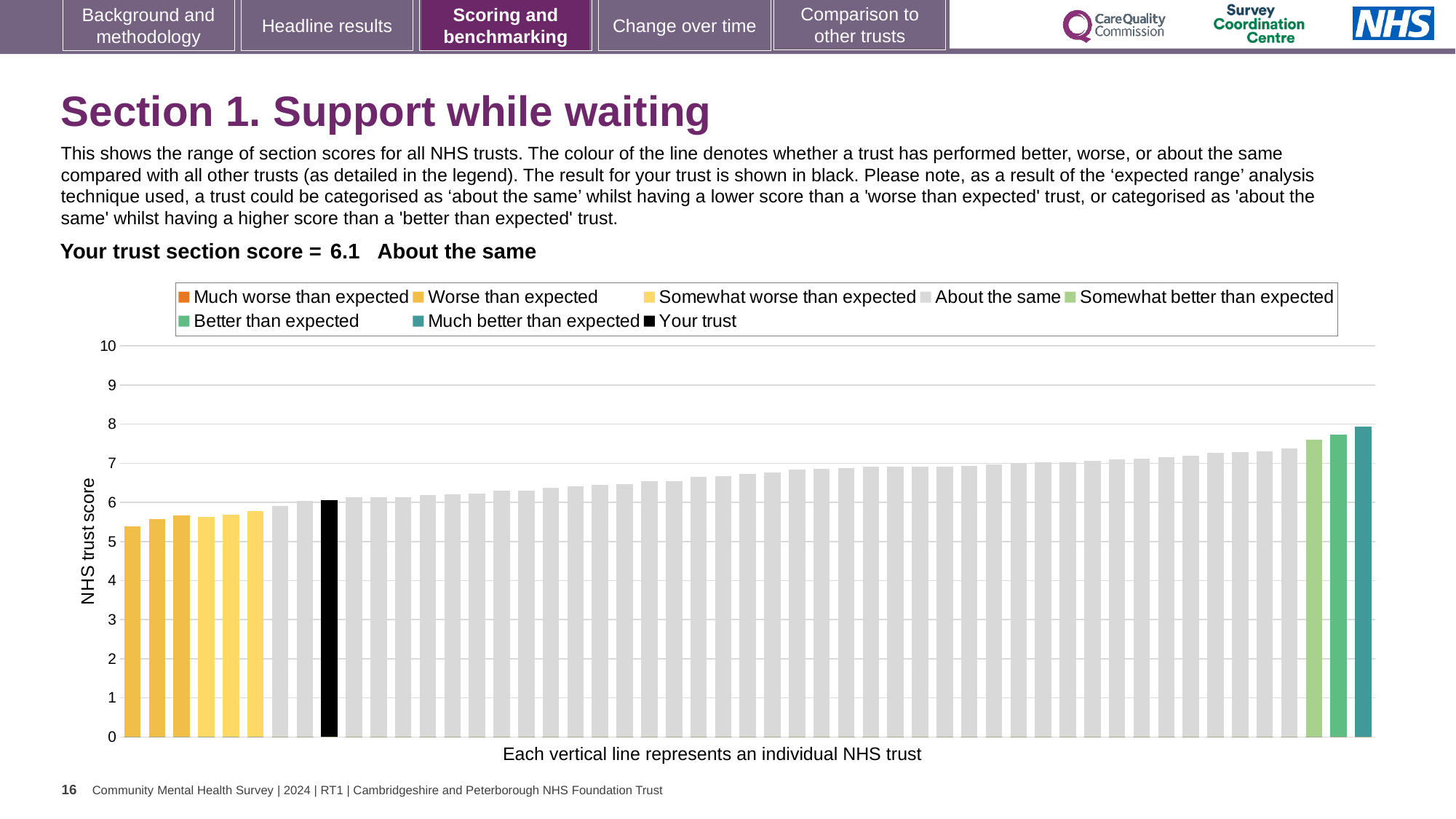
What is the title of the vertical axis? NHS trust score Which legend category does the shortest bar belong to? Worse than expected Which performance category is your trust placed in for this section? About the same Is the value of the black 'Your trust' bar greater or less than 5? greater Do the bar values rise or fall moving from left to right along the x axis? rise What kind of chart is shown on the slide? bar chart Which legend category does the tallest bar belong to? Much better than expected Is the value of the shortest bar in the chart greater or less than 6? less What colour is used for the 'Your trust' bar? black How many entries does the chart legend list? 8 Is the value of the tallest bar in the chart greater or less than 7? greater What is the section score for your trust shown on the slide? 6.1